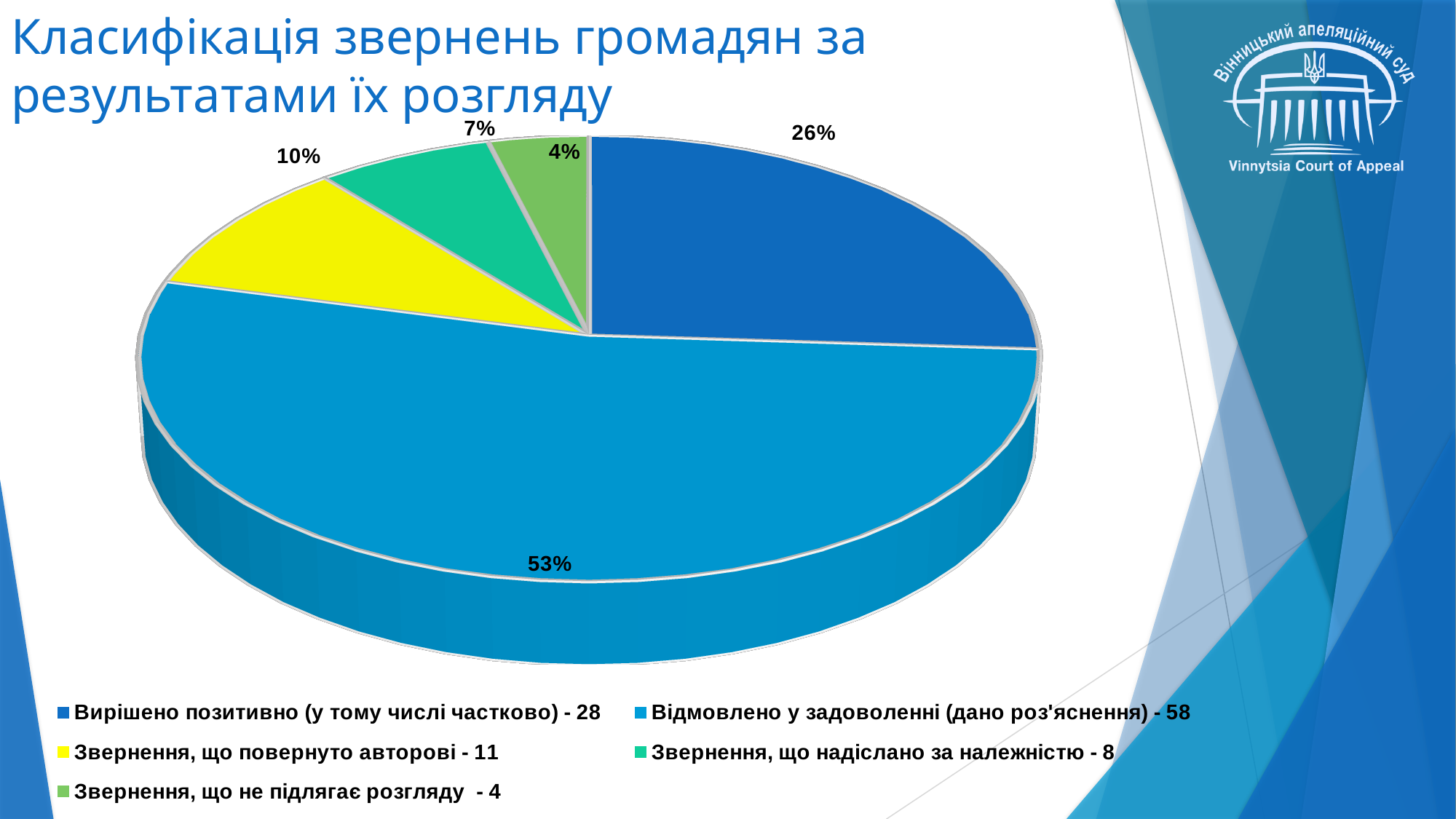
What percentage share is shown for "Звернення, що повернуто авторові"? 10% Which category has the largest slice of the pie? Відмовлено у задоволенні (дано роз'яснення) What is the title of the chart slide? Класифікація звернень громадян за результатами їх розгляду What percentage share is shown for "Звернення, що не підлягає розгляду"? 4% What kind of chart is shown on the slide? pie chart What percentage share is shown for "Відмовлено у задоволенні (дано роз'яснення)"? 53% How many slices does the pie chart have? 5 Which slice is larger: "Звернення, що повернуто авторові" or "Звернення, що надіслано за належністю"? Звернення, що повернуто авторові Which category has the smallest slice of the pie? Звернення, що не підлягає розгляду What is the difference in percentage points between the "Відмовлено у задоволенні" slice and the "Вирішено позитивно" slice? 27 According to the legend, how many appeals were "Звернення, що надіслано за належністю"? 8